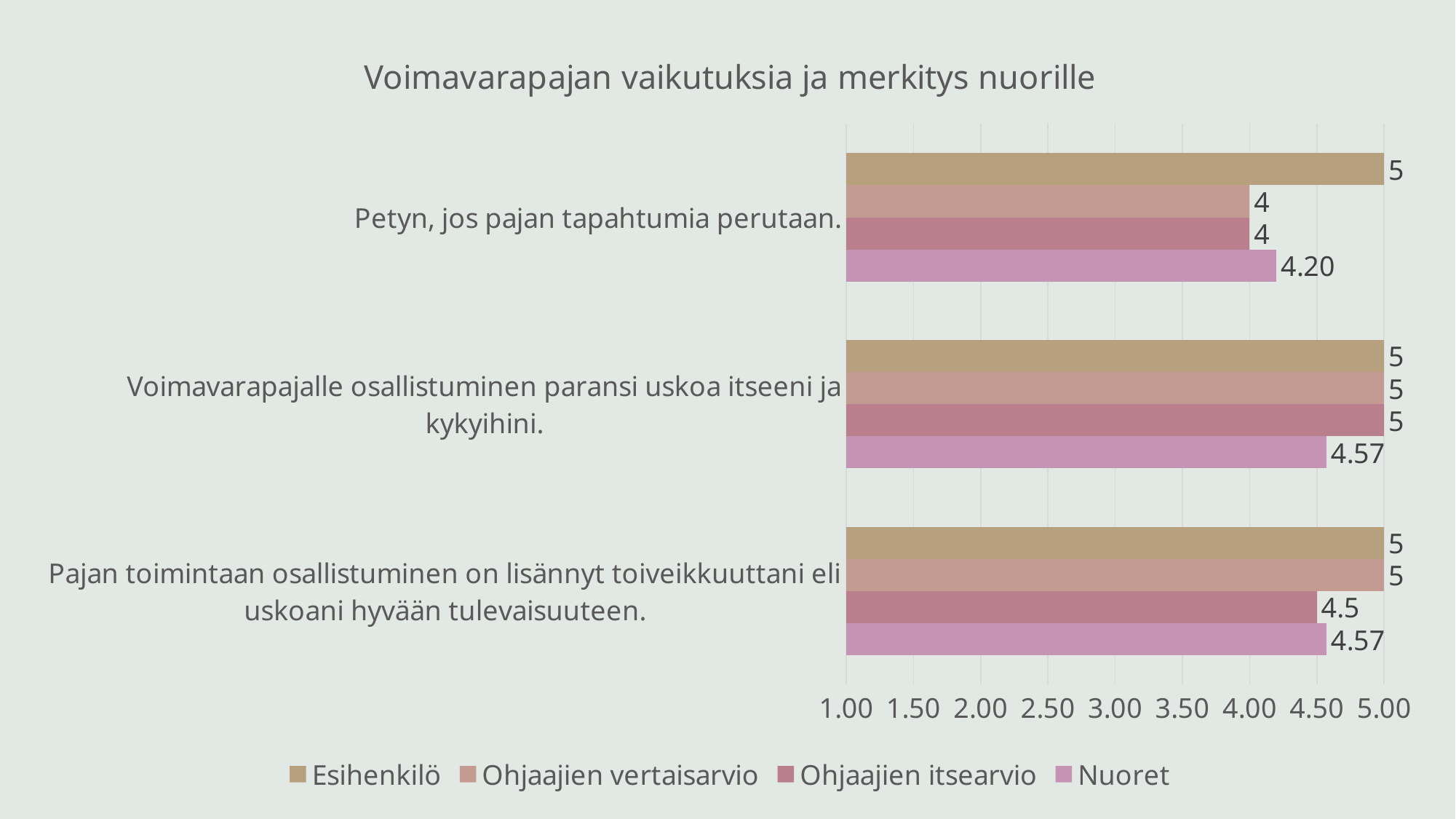
Which series is shown in the lightest pink colour in the legend? Nuoret What is the Ohjaajien vertaisarvio value for "Petyn, jos pajan tapahtumia perutaan."? 4 What is the difference between the Esihenkilö and Nuoret values for "Petyn, jos pajan tapahtumia perutaan."? 0.80 What is the Nuoret value for "Voimavarapajalle osallistuminen paransi uskoa itseeni ja kykyihini."? 4.57 What is the Nuoret value for "Petyn, jos pajan tapahtumia perutaan."? 4.20 For "Pajan toimintaan osallistuminen on lisännyt toiveikkuuttani eli uskoani hyvään tulevaisuuteen.", which is larger: the Ohjaajien itsearvio value or the Nuoret value? Nuoret Which series has the lowest value for "Voimavarapajalle osallistuminen paransi uskoa itseeni ja kykyihini."? Nuoret What is the title of the chart? Voimavarapajan vaikutuksia ja merkitys nuorille What kind of chart is shown on the slide? Bar chart What is the Ohjaajien itsearvio value for "Pajan toimintaan osallistuminen on lisännyt toiveikkuuttani eli uskoani hyvään tulevaisuuteen."? 4.5 How many series does the legend list? 4 How many categories are shown on the chart? 3